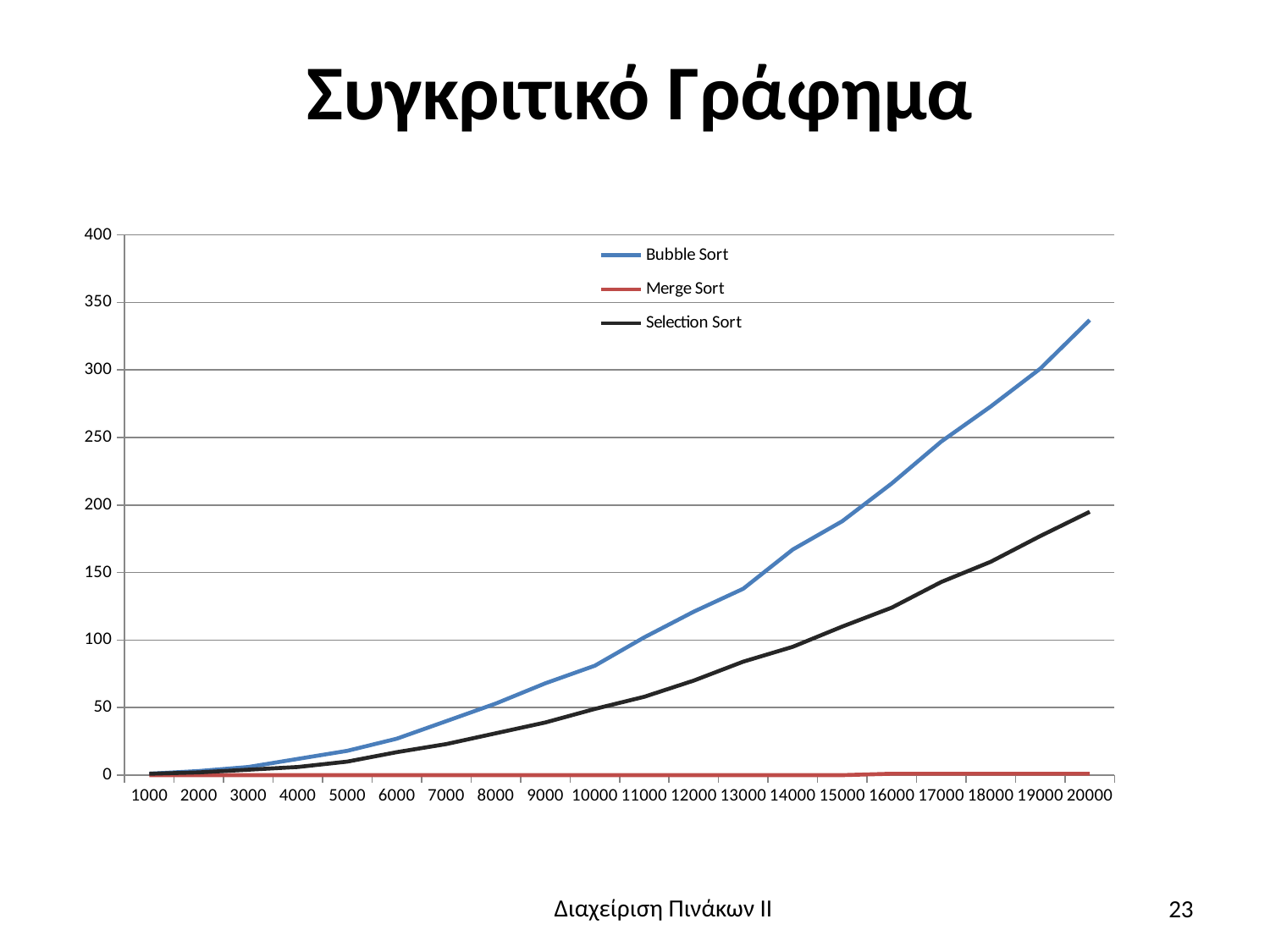
Is the value for Merge Sort at 20000 greater or less than 50? less How many points are plotted along the x axis for each series? 20 At 20000, which is larger: Bubble Sort or Selection Sort? Bubble Sort How many series does the legend list? 3 Do the Bubble Sort values rise or fall as the x axis goes from 1000 to 20000? rise Is the value for Bubble Sort at 20000 greater or less than 300? greater What is the title of the slide containing the chart? Συγκριτικό Γράφημα Is the value for Selection Sort at 20000 greater or less than 250? less Which series has the lowest value at 20000? Merge Sort Which series has the highest value at 20000? Bubble Sort What kind of chart is shown on the slide? line chart